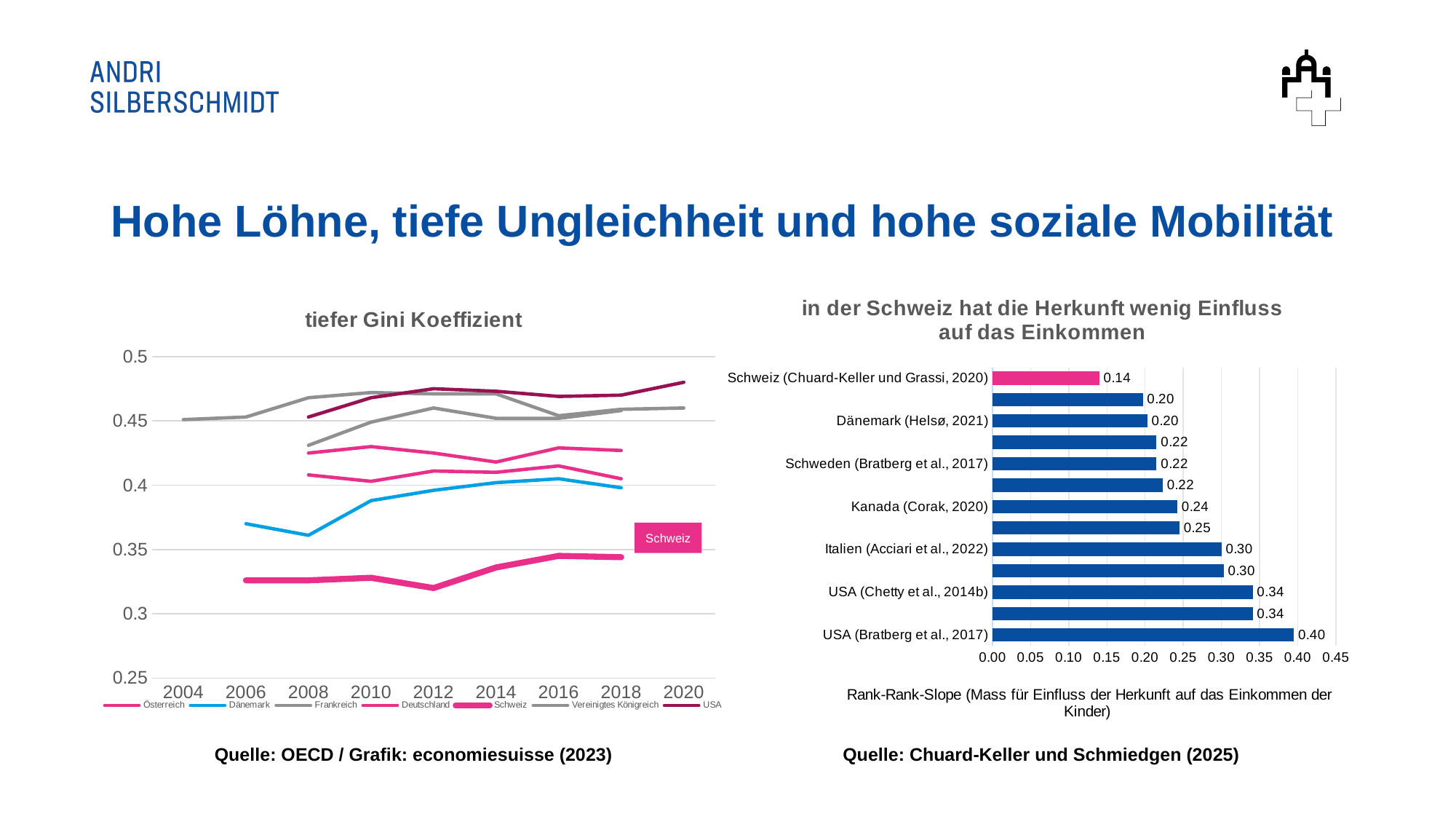
On the right chart, what is the value for USA (Bratberg et al., 2017)? 0.40 What kind of chart is the left chart titled 'tiefer Gini Koeffizient'? line chart On the left chart, is the value for USA in 2020 greater or less than 0.45? greater On the right chart, which is larger: Italien (Acciari et al., 2022) or Dänemark (Helsø, 2021)? Italien (Acciari et al., 2022) How many series does the legend of the left chart list? 7 On the right chart, what is the value for Schweiz (Chuard-Keller und Grassi, 2020)? 0.14 On the right chart, what is the difference between USA (Bratberg et al., 2017) and Schweiz (Chuard-Keller und Grassi, 2020)? 0.26 On the right chart, what is the value for Kanada (Corak, 2020)? 0.24 On the right chart, which labelled category has the highest value? USA (Bratberg et al., 2017) How many bars are plotted on the right chart? 13 On the right chart, which labelled category has the lowest value? Schweiz (Chuard-Keller und Grassi, 2020) On the left chart, is the value for Schweiz in 2018 greater or less than 0.4? less